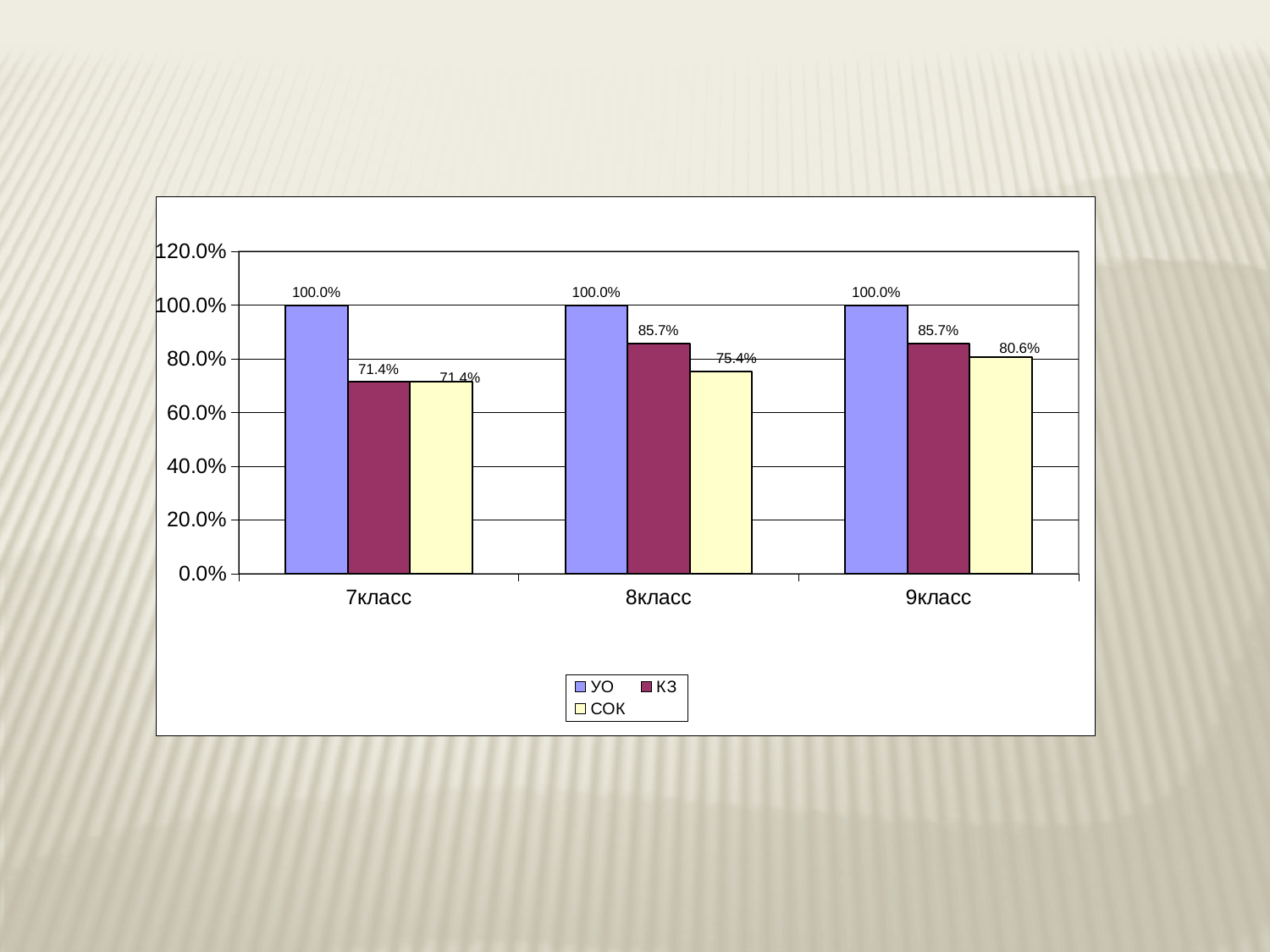
What is the value for СОК in 7класс? 71.4% What is the value for УО in 7класс? 100.0% Which is larger in 8класс, КЗ or СОК? КЗ Which class has the highest value for СОК? 9класс What is the value for КЗ in 8класс? 85.7% How many classes are shown on the x axis? 3 What is the difference between the УО and КЗ values in 7класс? 28.6% What kind of chart is shown on the slide? Bar chart Which class has the lowest value for СОК? 7класс What is the value for СОК in 9класс? 80.6% How many series does the legend list? 3 What is the difference between the СОК values in 9класс and 8класс? 5.2%